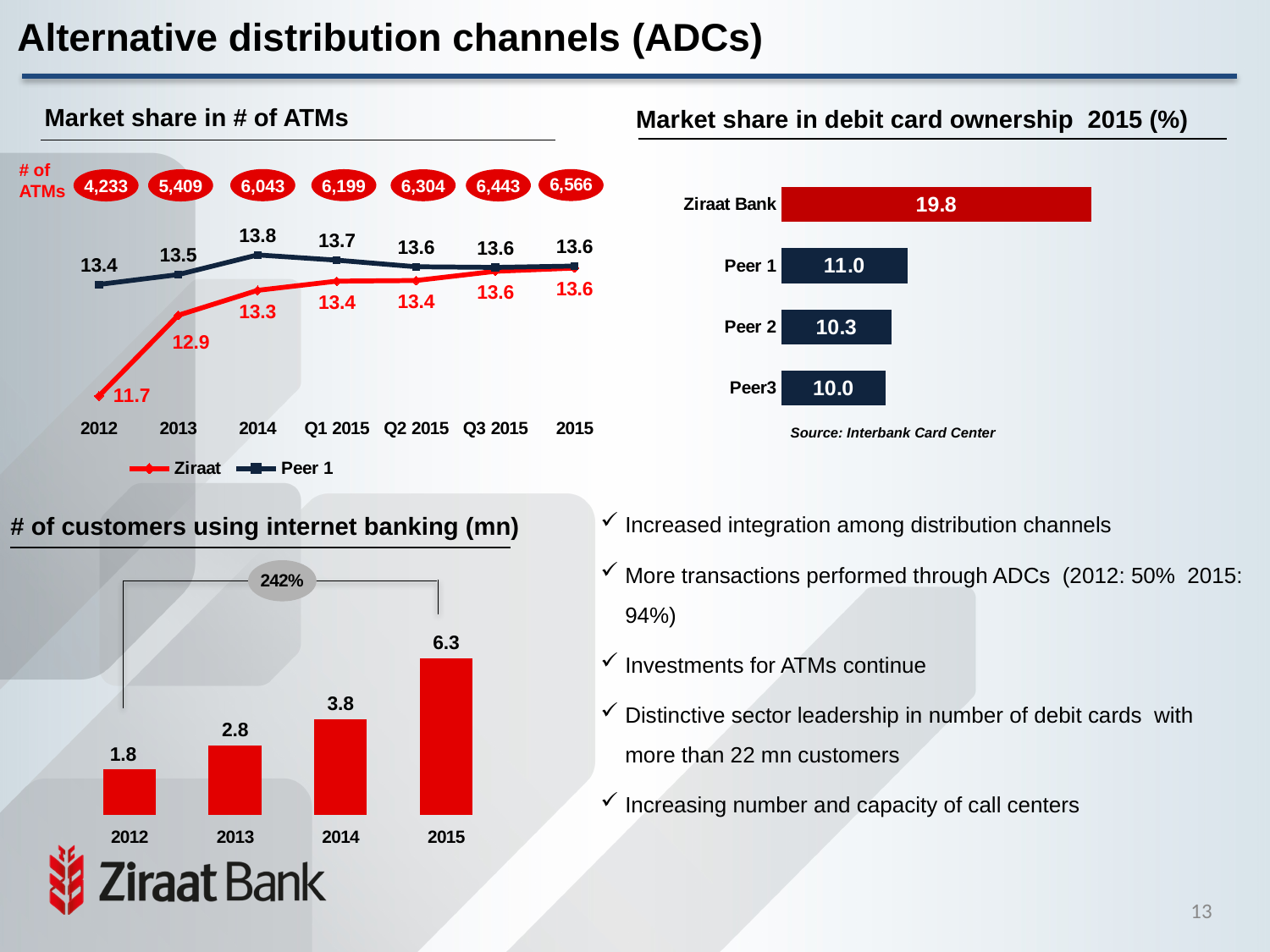
In the '# of customers using internet banking (mn)' chart, how many years are shown? 4 In the 'Market share in debit card ownership 2015 (%)' chart, what is the value for Peer 2? 10.3 In the '# of customers using internet banking (mn)' chart, what is the value for 2014? 3.8 In the 'Market share in # of ATMs' chart, what is the difference between Peer 1 and Ziraat in 2013? 0.6 In the 'Market share in debit card ownership 2015 (%)' chart, which category has the highest value? Ziraat Bank In the 'Market share in # of ATMs' chart, what is the Ziraat value for 2012? 11.7 In the 'Market share in debit card ownership 2015 (%)' chart, what is the difference between Ziraat Bank and Peer 1? 8.8 In the 'Market share in # of ATMs' chart, what is the Peer 1 value for 2014? 13.8 In the 'Market share in # of ATMs' chart, what is the number of ATMs shown for 2015? 6,566 In the 'Market share in # of ATMs' chart, does the Ziraat series rise or fall from 2012 to 2015? rise What kind of chart is the '# of customers using internet banking (mn)' chart? bar chart In the 'Market share in # of ATMs' chart, how many series does the legend list? 2